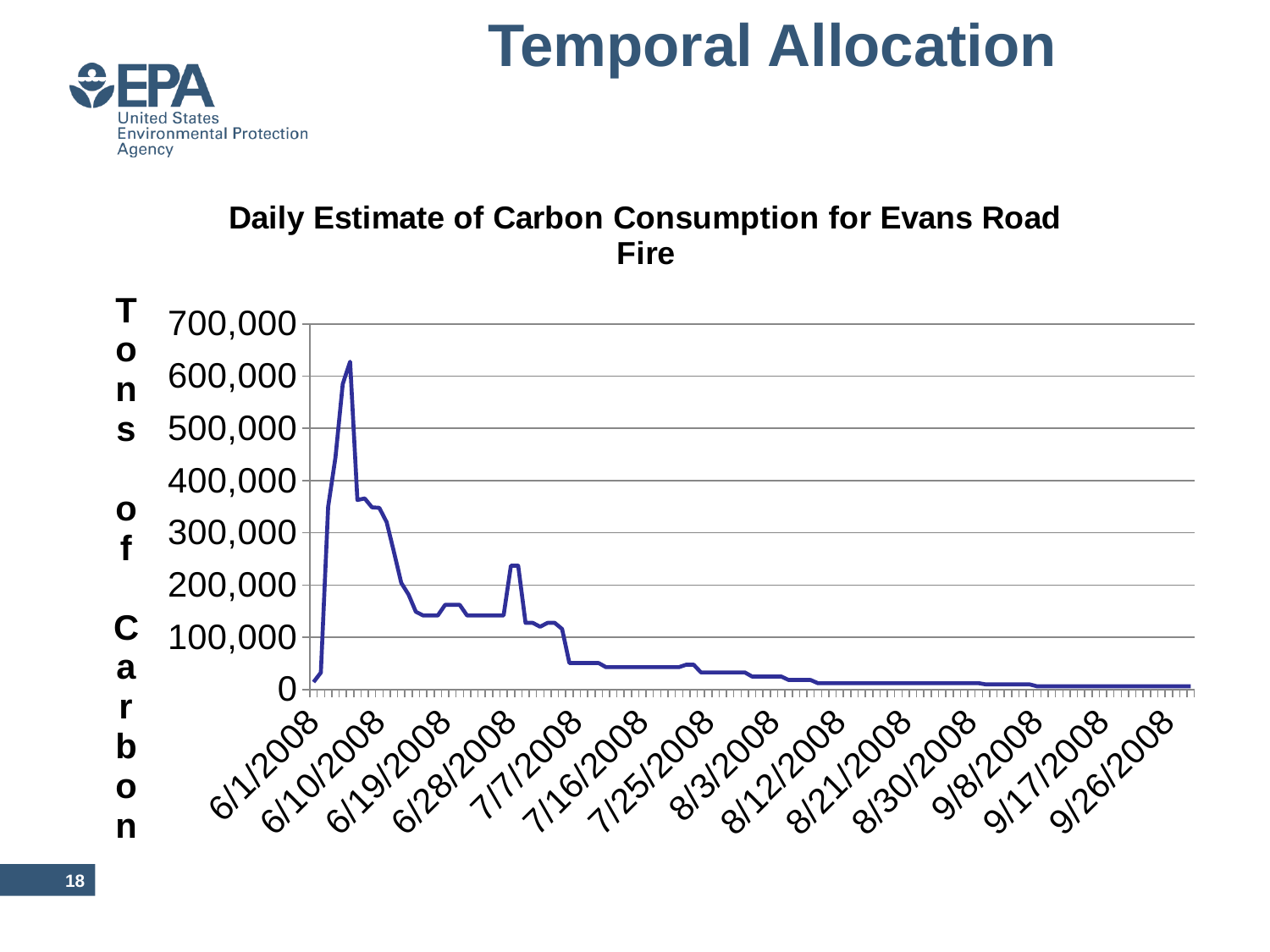
Is the value for 6/1/2008 greater or less than 100,000? less Do the values rise or fall along the x axis from 6/10/2008 to 9/26/2008? fall Is the peak value of the line greater or less than 600,000? greater Is the value for 6/10/2008 greater or less than 300,000? greater Which is larger, the value for 6/1/2008 or the value for 6/10/2008? 6/10/2008 How many date labels are shown on the x axis? 14 What is the label on the y axis of the chart? Tons of Carbon What is the title of the chart? Daily Estimate of Carbon Consumption for Evans Road Fire What kind of chart is shown on the slide? line chart Which is larger, the value for 6/10/2008 or the value for 7/7/2008? 6/10/2008